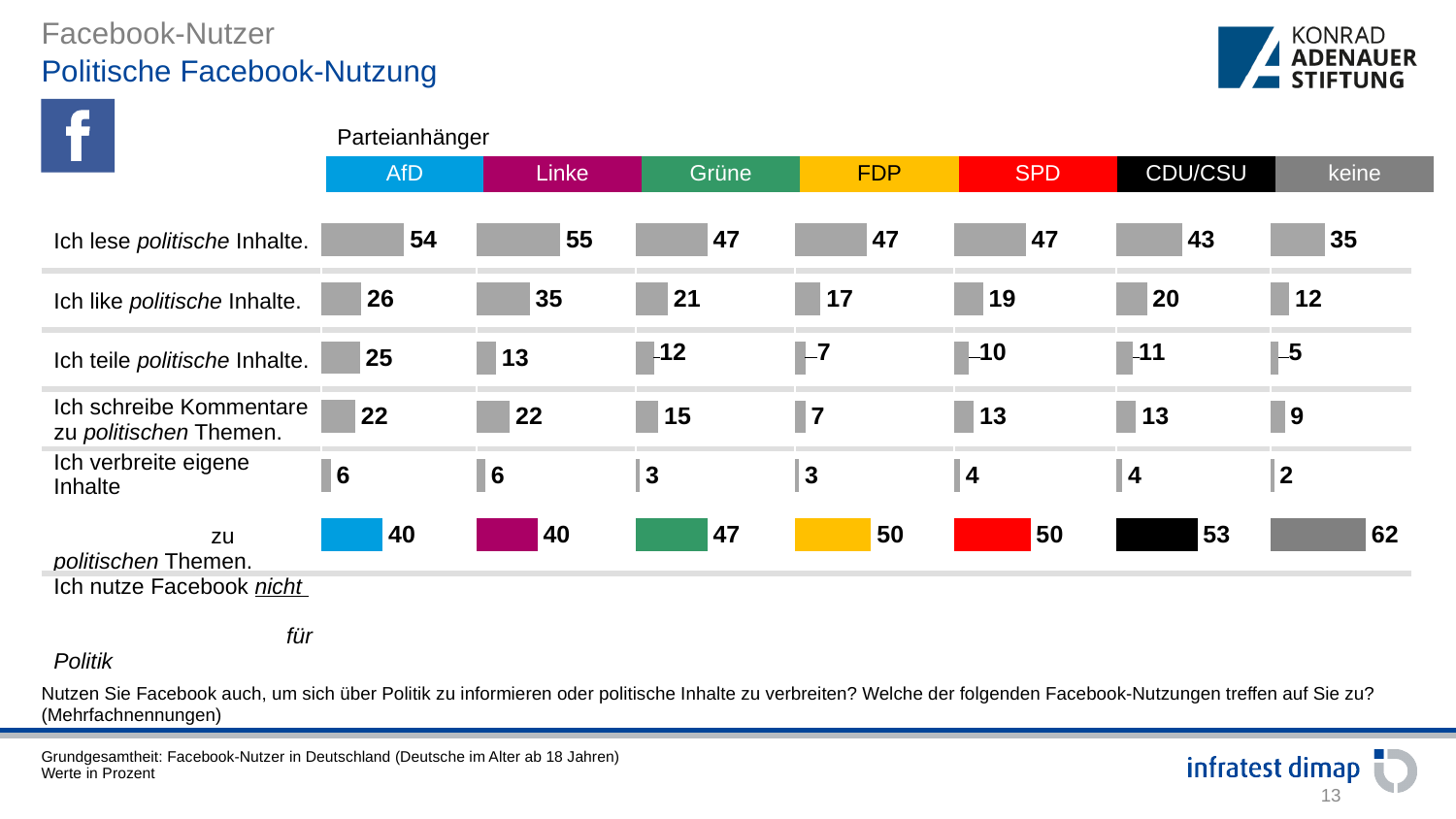
Which is larger for "Ich schreibe Kommentare zu politischen Themen": AfD or Grüne? AfD What is the value for Linke supporters for "Ich like politische Inhalte"? 35 What is the difference between AfD and CDU/CSU for "Ich lese politische Inhalte"? 11 Which party group has the lowest value for "Ich teile politische Inhalte"? keine Which party group has the highest value for "Ich lese politische Inhalte"? Linke What type of chart is used on this slide? Bar chart What colour is the column header for the SPD? Red What is the value for SPD supporters for "Ich verbreite eigene Inhalte zu politischen Themen"? 4 What is the value for "keine" (no party) for "Ich nutze Facebook nicht für Politik"? 62 How many party groups are shown in the chart? 7 What is the value for FDP supporters for "Ich teile politische Inhalte"? 7 What percentage of AfD supporters say "Ich lese politische Inhalte"? 54